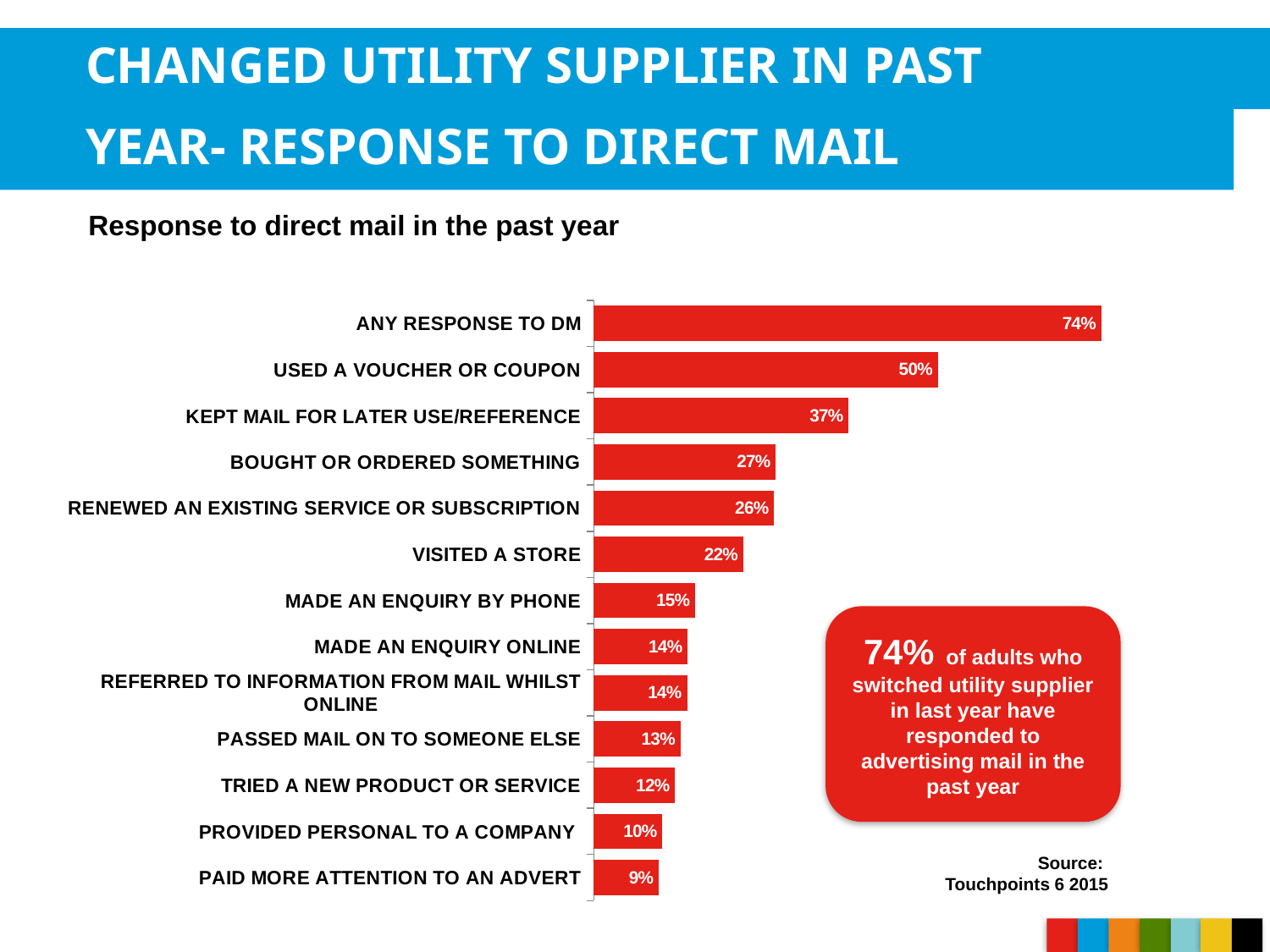
Which category has the highest value? ANY RESPONSE TO DM How many categories are shown in the chart? 13 What is the value for KEPT MAIL FOR LATER USE/REFERENCE? 37% Which is larger, RENEWED AN EXISTING SERVICE OR SUBSCRIPTION or MADE AN ENQUIRY BY PHONE? RENEWED AN EXISTING SERVICE OR SUBSCRIPTION What is the difference between USED A VOUCHER OR COUPON and BOUGHT OR ORDERED SOMETHING? 23% What is the source cited for the chart data? Touchpoints 6 2015 What is the value for PASSED MAIL ON TO SOMEONE ELSE? 13% What is the value for ANY RESPONSE TO DM? 74% What is the value for VISITED A STORE? 22% What kind of chart is shown on the slide? Bar chart Which category has the lowest value? PAID MORE ATTENTION TO AN ADVERT What is the difference between ANY RESPONSE TO DM and PROVIDED PERSONAL TO A COMPANY? 64%